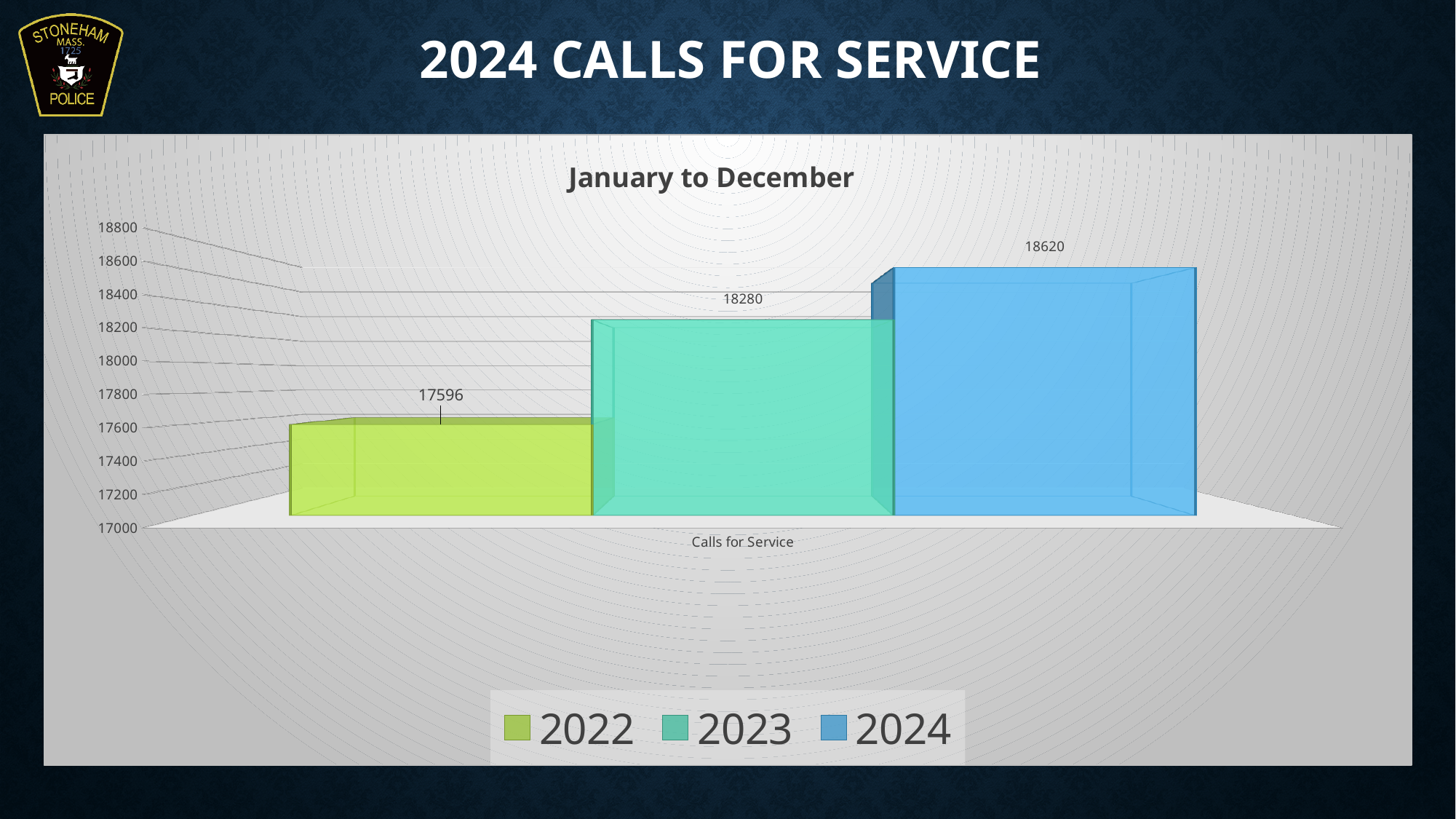
What is the value for 2024 in the Calls for Service chart? 18620 Which is larger, the value for 2022 or the value for 2023? 2023 What is the value for 2022 in the Calls for Service chart? 17596 What kind of chart is shown on the slide? bar chart What is the difference between the 2024 and 2023 values? 340 Which year has the lowest number of calls for service? 2022 Is the value for 2022 greater or less than 17800? less Which year has the highest number of calls for service? 2024 What is the value for 2023 in the Calls for Service chart? 18280 What is the title of the chart? January to December How many series does the legend list? 3 What is the difference between the 2023 and 2022 values? 684